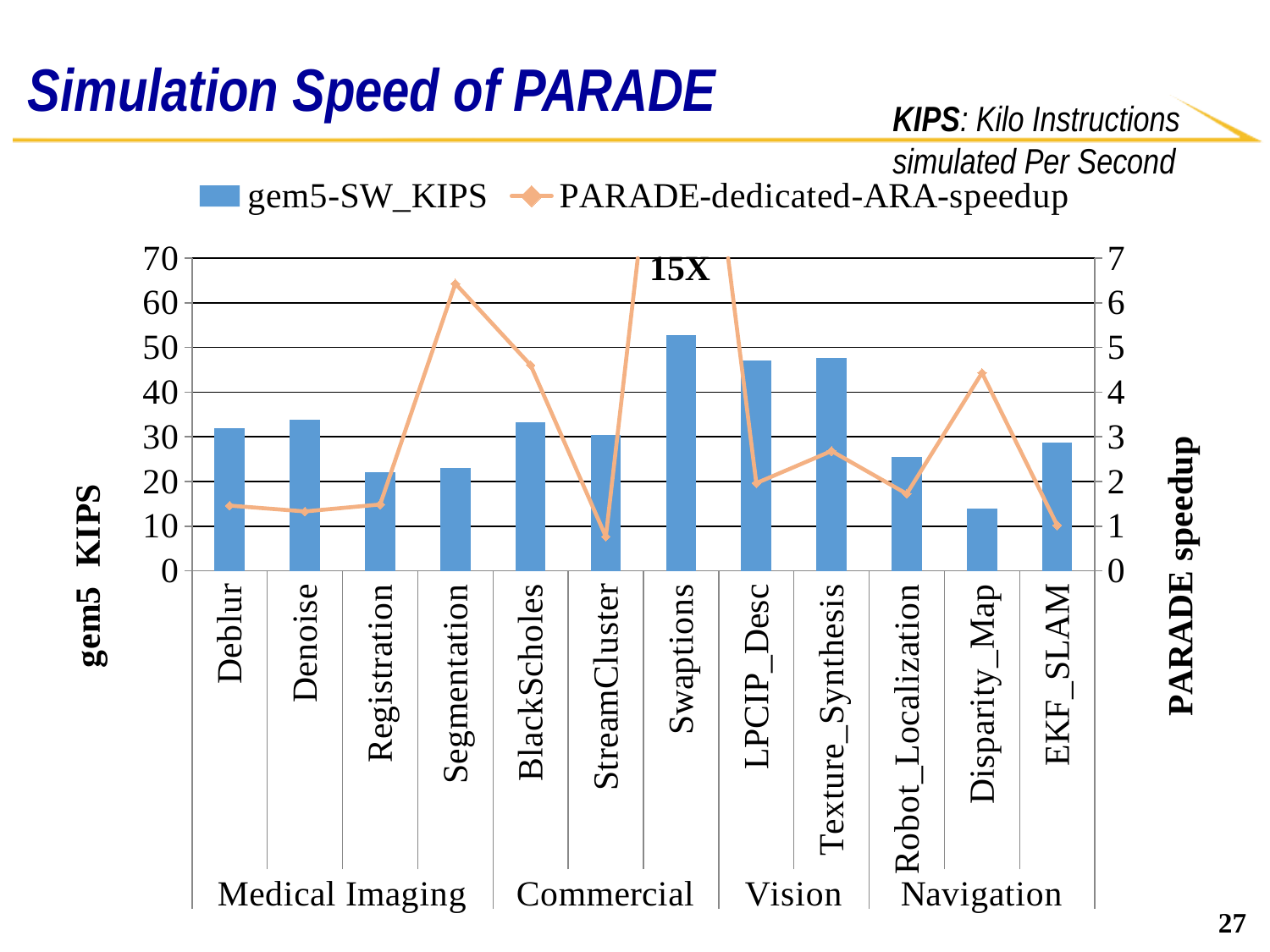
Is the gem5-SW_KIPS value for Disparity_Map greater or less than 20? less Is the gem5-SW_KIPS value for Swaptions greater or less than 50? greater Which has the larger gem5-SW_KIPS value, Swaptions or Deblur? Swaptions Which benchmark has the highest gem5-SW_KIPS bar? Swaptions Is the PARADE-dedicated-ARA-speedup for StreamCluster greater or less than 1? less How many benchmarks are plotted along the x axis? 12 What PARADE-dedicated-ARA-speedup is labelled for Swaptions? 15X What are the four benchmark groups labelled below the x axis? Medical Imaging, Commercial, Vision, Navigation How many series does the legend list? 2 Which benchmark has the lowest gem5-SW_KIPS bar? Disparity_Map What kind of chart is shown on the slide? A combined bar and line chart